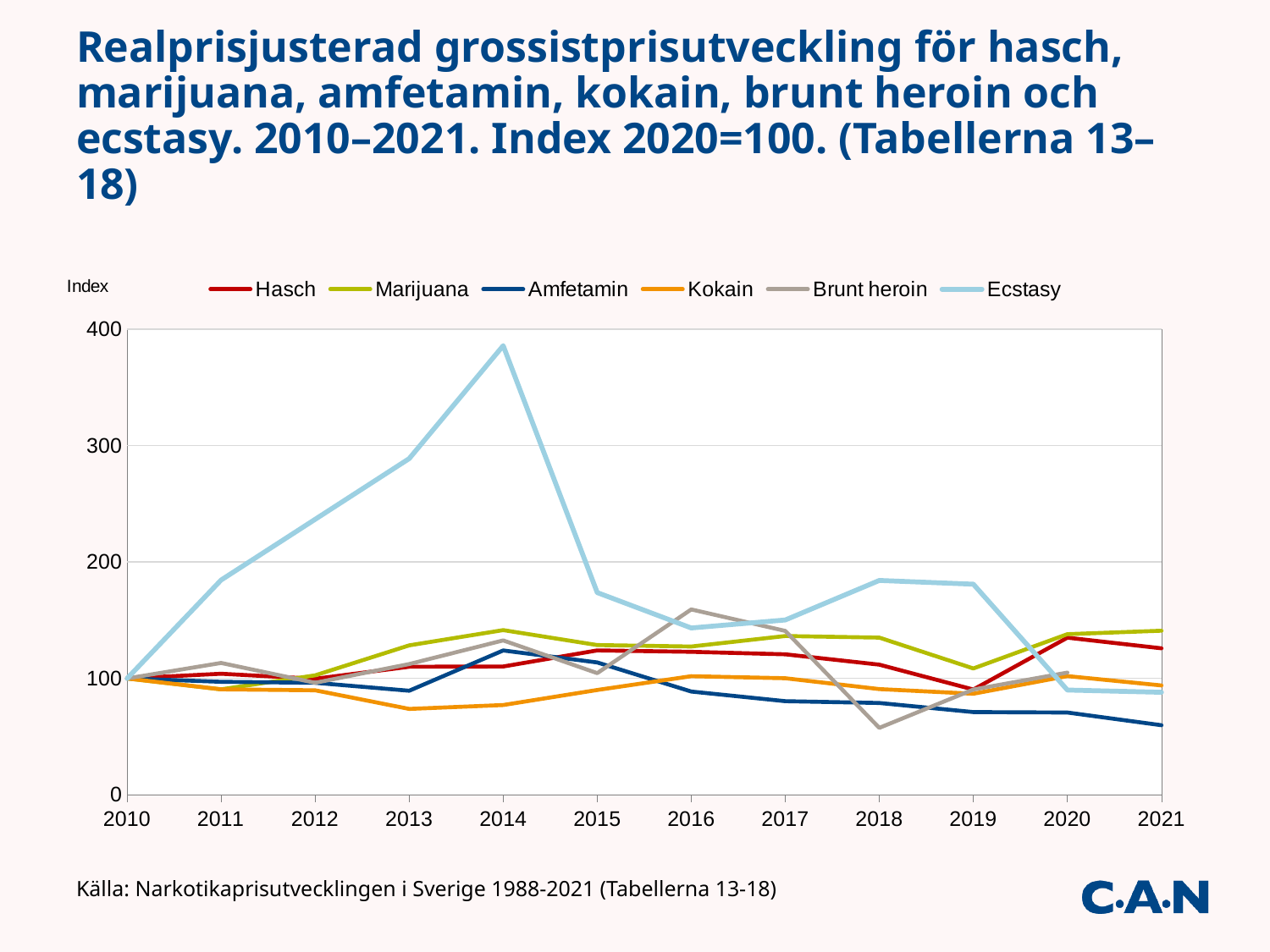
How many years are shown along the x axis? 12 What label is shown on the y axis? Index Does the Ecstasy line rise or fall from 2010 to 2014? rise Is the value for Brunt heroin in 2018 greater or less than 100? less Is the value for Ecstasy in 2011 greater or less than 100? greater Is the value for Ecstasy in 2014 greater or less than 300? greater What kind of chart is shown on the slide? line chart Which series has the lowest value in 2018? Brunt heroin Which is larger in 2013, the value for Ecstasy or the value for Kokain? Ecstasy How many series does the legend list? 6 Which series has the highest value in 2014? Ecstasy